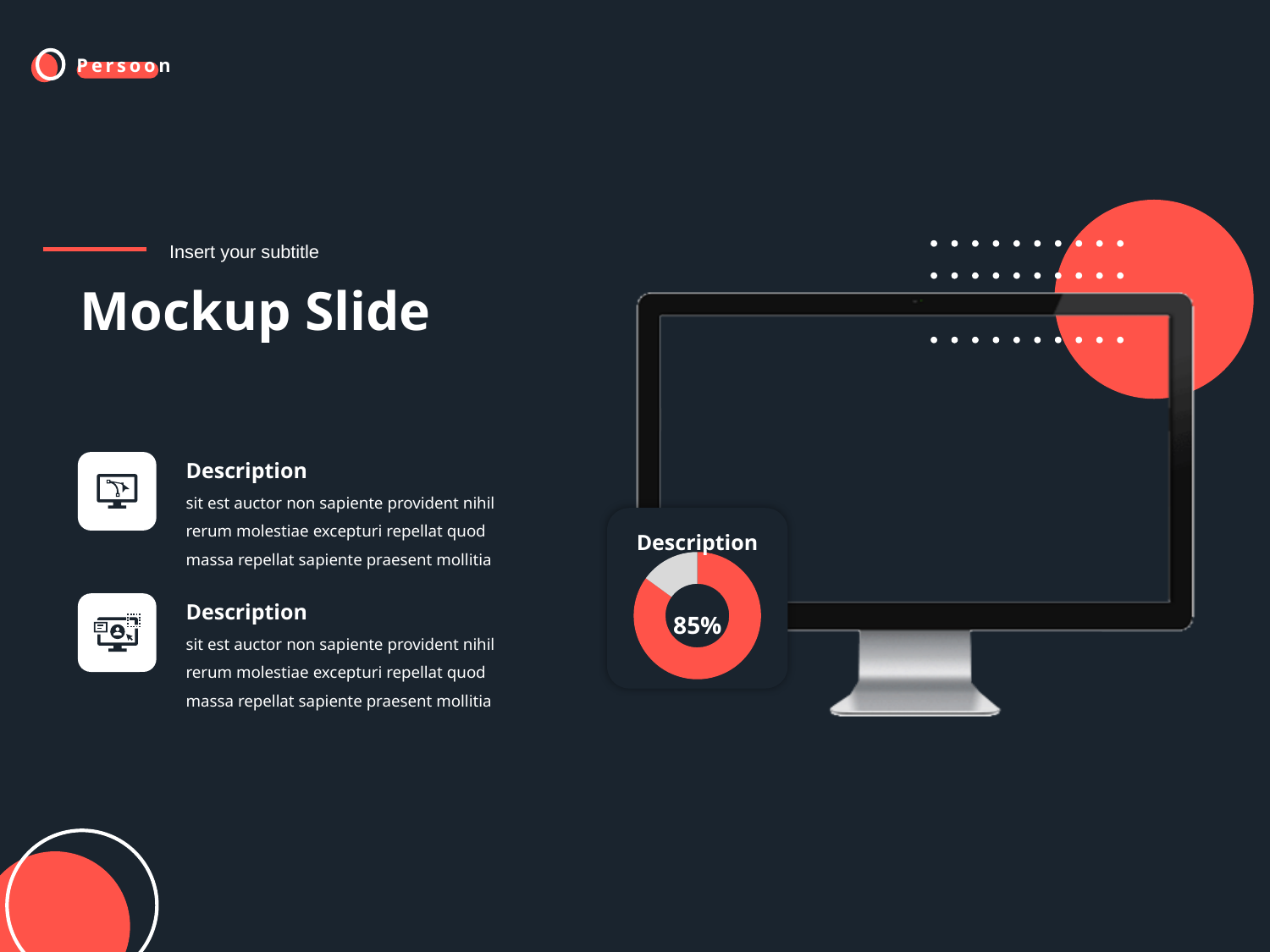
Which slice of the donut chart is larger, the red one or the grey one? The red one How many slices does the donut chart have? 2 What is the title shown above the donut chart? Description What colour is the slice of the donut chart that represents 85%? Red What percentage value is printed in the centre of the donut chart? 85% What kind of chart is shown on the slide? Donut chart